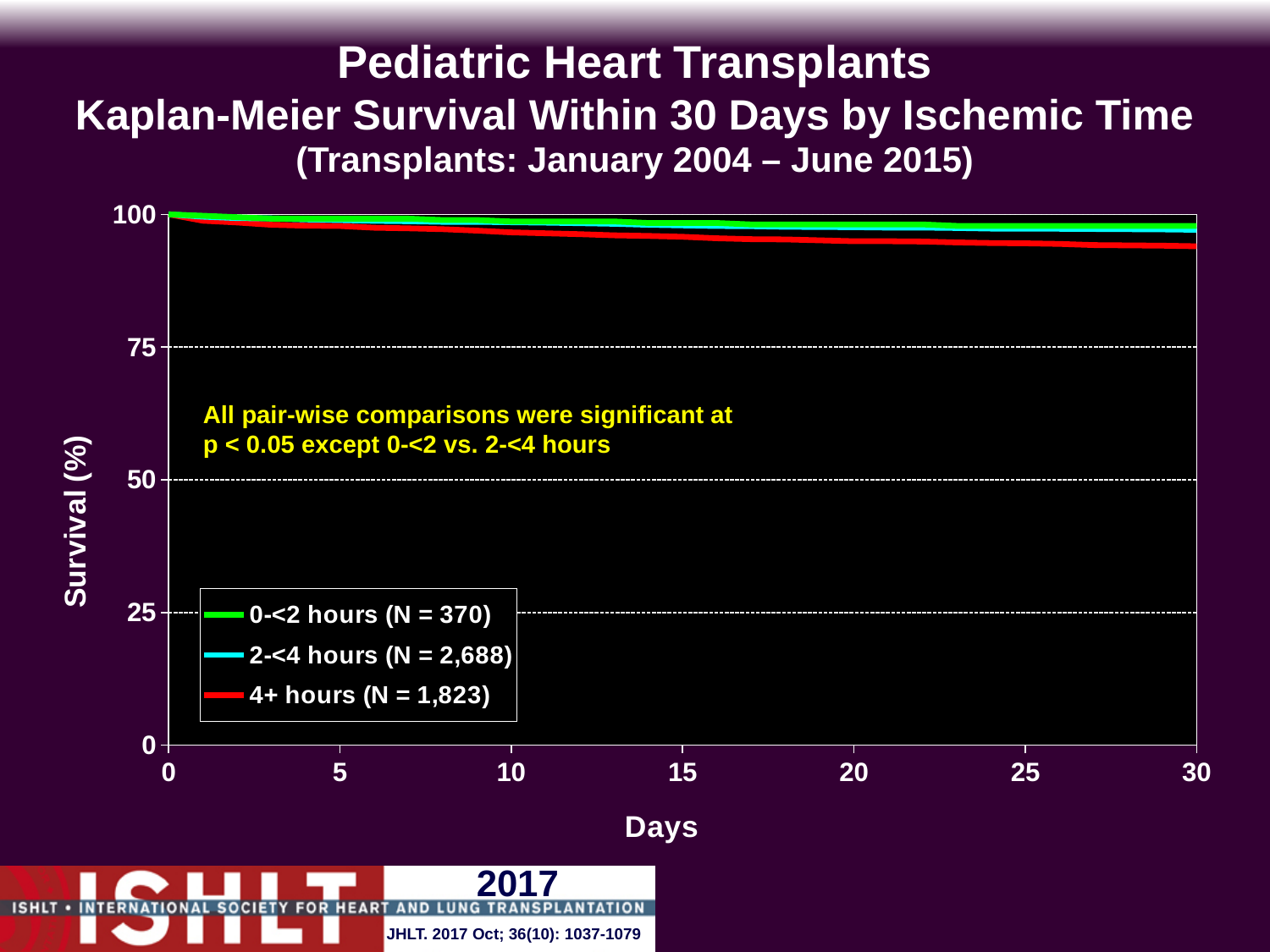
What is the N shown in the legend for the 2-<4 hours group? 2,688 Is the survival for the 2-<4 hours group at 15 days greater or less than 50? greater What kind of chart is shown on the slide? line chart Do the survival curves rise or fall as days increase? fall How many series does the legend list? 3 Is the survival for the 0-<2 hours group at 30 days greater or less than 75? greater What is the label of the y axis? Survival (%) Is the survival for the 4+ hours group at 30 days greater or less than 75? greater Which ischemic time group has the lowest survival at 30 days? 4+ hours At 30 days, which group has higher survival: 0-<2 hours or 4+ hours? 0-<2 hours At 30 days, which group has higher survival: 2-<4 hours or 4+ hours? 2-<4 hours What is the maximum value shown on the x axis (Days)? 30